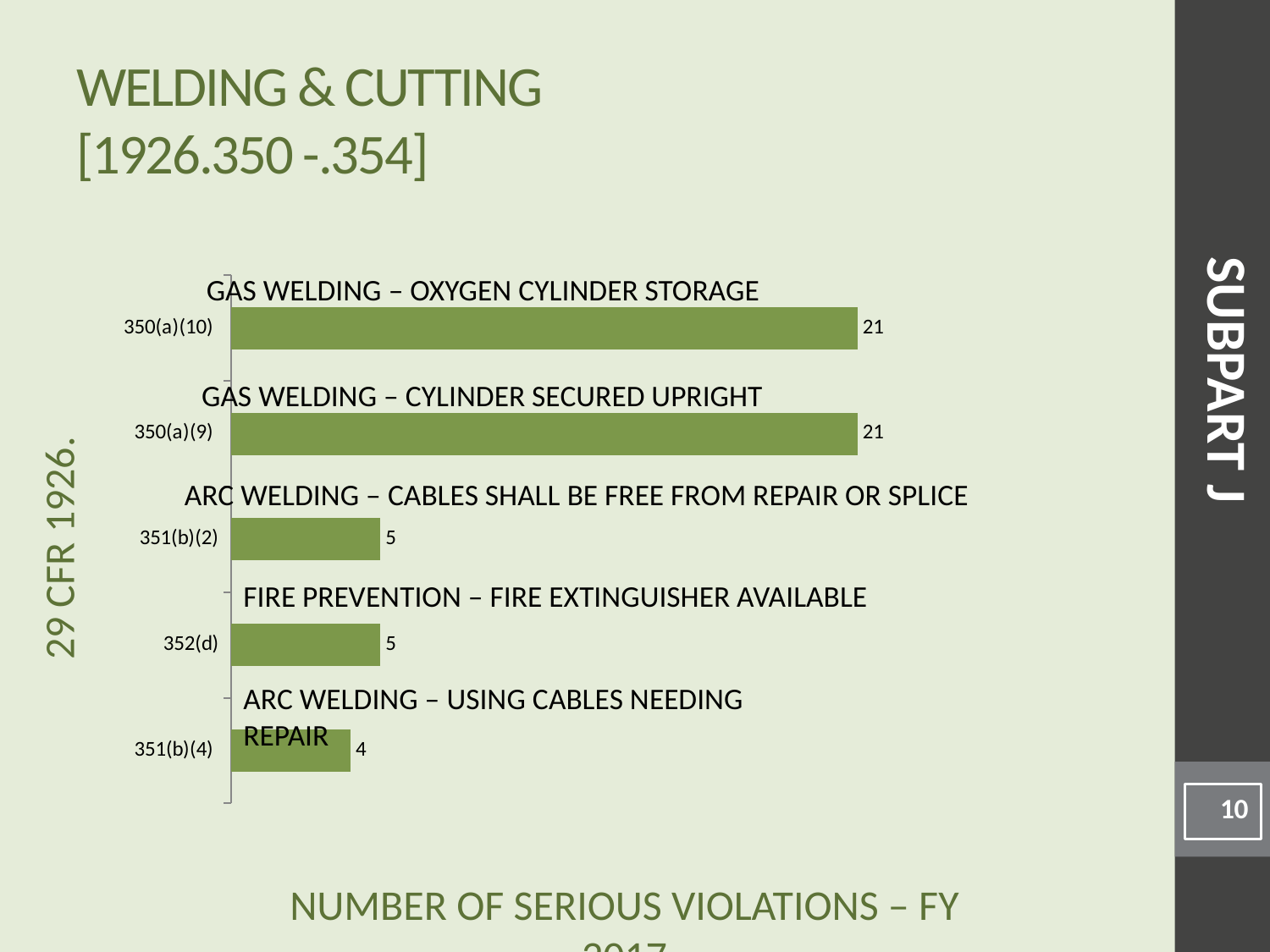
What is the difference between the values for 350(a)(9) and 351(b)(2)? 16 What is the number of serious violations for 351(b)(4)? 4 What is the number of serious violations for 350(a)(10)? 21 What is the difference between the values for 352(d) and 351(b)(4)? 1 What is the total of the values for 350(a)(10) and 350(a)(9)? 42 Which is larger, the value for 350(a)(10) or the value for 352(d)? 350(a)(10) How many categories are shown in the chart? 5 What is the number of serious violations for 351(b)(2)? 5 Which category has the lowest number of serious violations? 351(b)(4) What is the number of serious violations for 352(d)? 5 What kind of chart is shown on the slide? bar chart